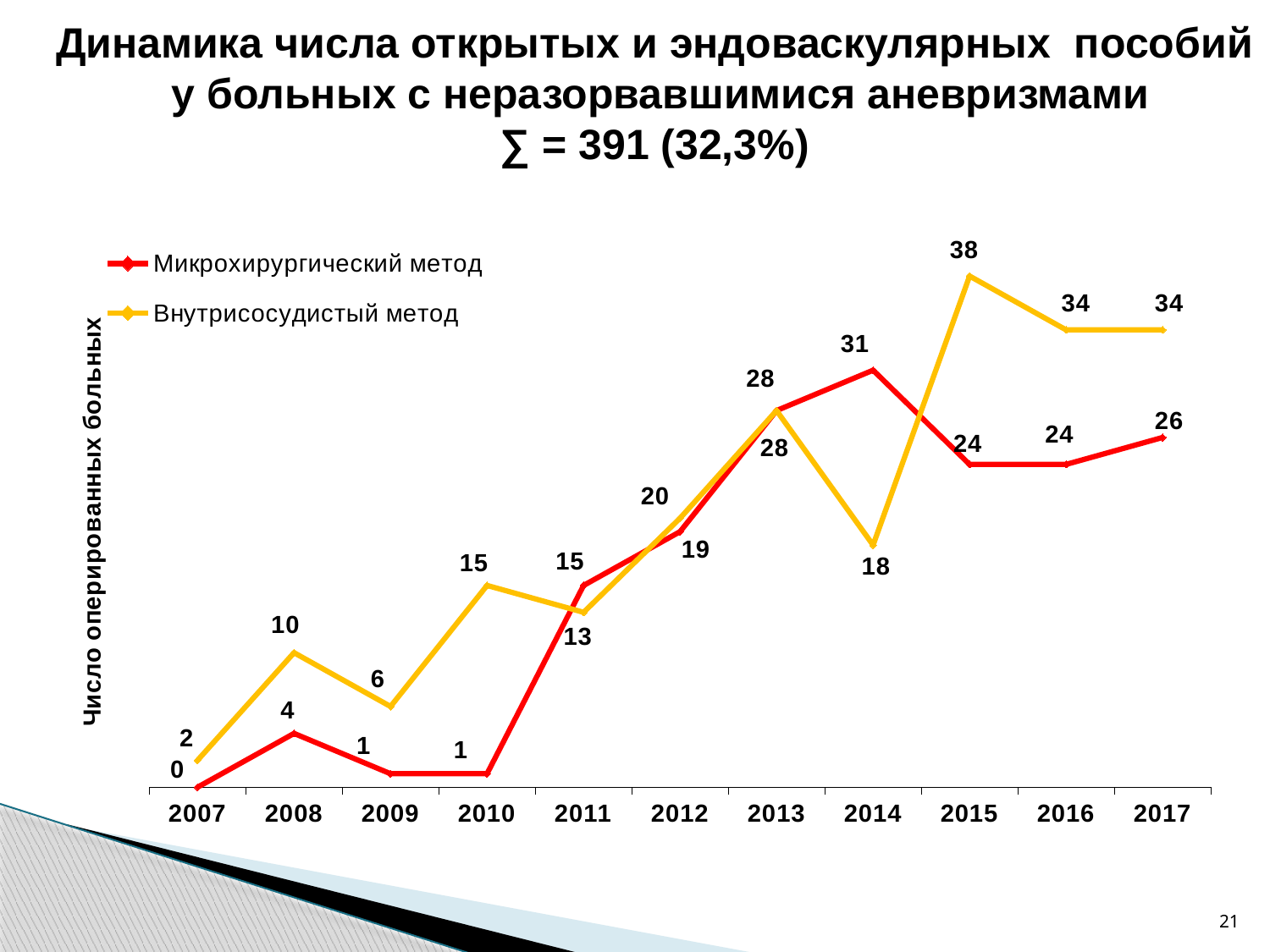
In which year does Внутрисосудистый метод reach its highest value? 2015 What is the value for Внутрисосудистый метод in 2015? 38 What is the value for Внутрисосудистый метод in 2008? 10 What total is given in the slide title? 391 (32,3%) How many years are shown on the x axis? 11 What is the value for Микрохирургический метод in 2014? 31 How many series does the legend list? 2 What is the difference between Внутрисосудистый метод and Микрохирургический метод in 2015? 14 In which year is the value for Микрохирургический метод lowest? 2007 Does the value for Микрохирургический метод rise or fall from 2010 to 2014? rise What type of chart is shown on the slide? line chart Which series has the larger value in 2014? Микрохирургический метод